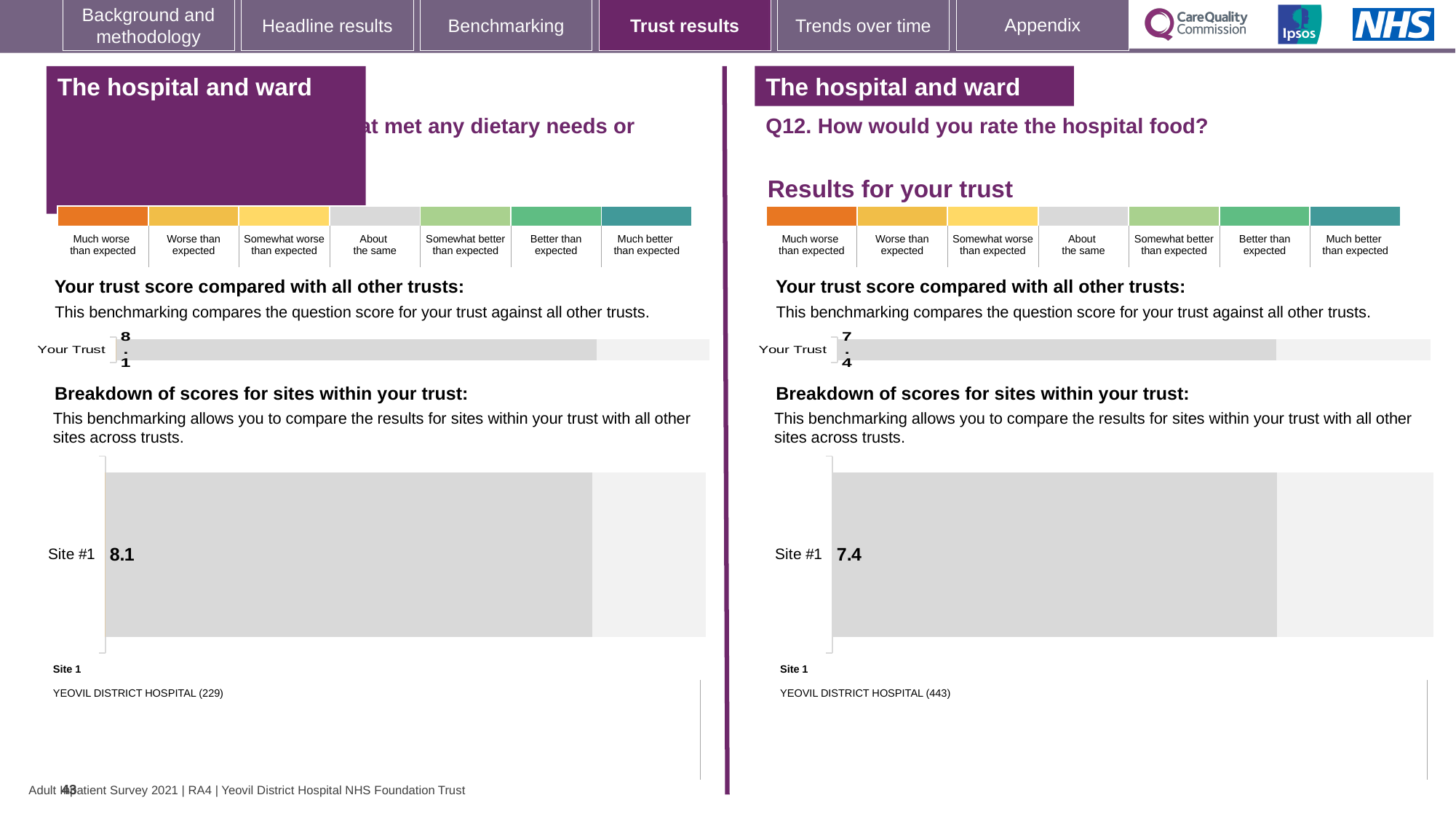
What is the name of Site 1 listed under the chart on the left half of the slide? YEOVIL DISTRICT HOSPITAL (229) On the left half of the slide, what is the score shown for Your Trust? 8.1 What is the difference between the Site #1 score on the left half of the slide and the Site #1 score on the right half (Q12)? 0.7 What kind of chart is used to show the Site #1 score on the right half of the slide (Q12)? Bar chart What is the name of Site 1 listed under the chart on the right half of the slide (Q12)? YEOVIL DISTRICT HOSPITAL (443) On the right half of the slide (Q12. How would you rate the hospital food?), what is the score shown for Site #1? 7.4 On the right half of the slide (Q12. How would you rate the hospital food?), what is the score shown for Your Trust? 7.4 How many sites are shown in the 'Breakdown of scores for sites within your trust' chart on the right half of the slide (Q12)? 1 How many sites are shown in the 'Breakdown of scores for sites within your trust' chart on the left half of the slide? 1 On the left half of the slide, what is the score shown for Site #1? 8.1 Which is larger: the Your Trust score on the left half of the slide or the Your Trust score on the right half (Q12)? Left half (8.1)